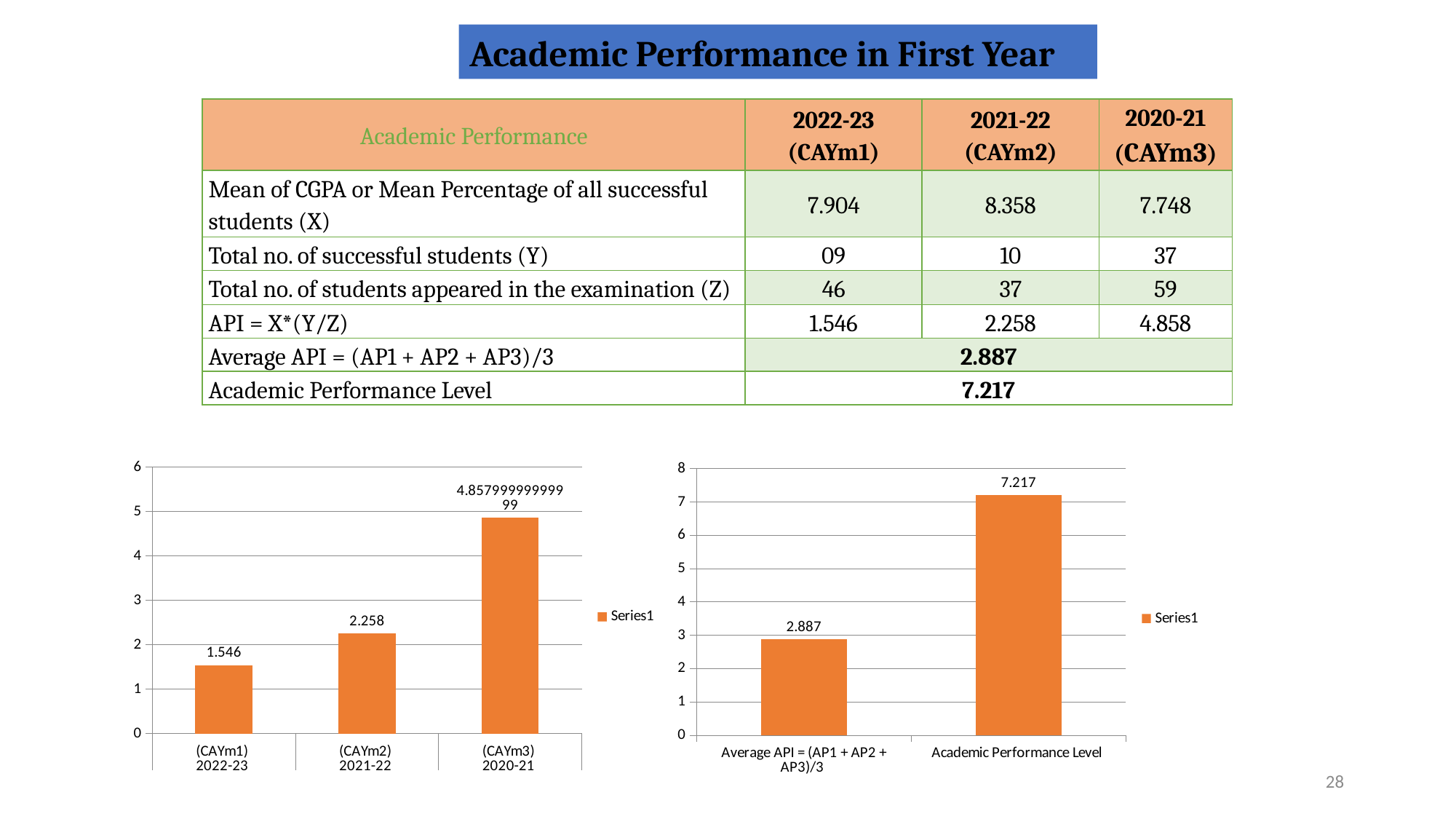
In the right chart, what is the value for Average API = (AP1 + AP2 + AP3)/3? 2.887 In the left chart, what is the value for (CAYm2) 2021-22? 2.258 In the left chart, what is the difference between the values for (CAYm2) 2021-22 and (CAYm1) 2022-23? 0.712 What kind of chart is the right chart? bar chart In the left chart, how many bars are plotted? 3 In the left chart, which category has the highest value? (CAYm3) 2020-21 In the left chart, do the values rise or fall from left to right along the x axis? rise In the left chart, which category has the lowest value? (CAYm1) 2022-23 In the left chart, is the value for (CAYm3) 2020-21 greater or less than 4? greater In the right chart, what is the difference between Academic Performance Level and Average API = (AP1 + AP2 + AP3)/3? 4.33 In the left chart, what is the value for (CAYm1) 2022-23? 1.546 In the right chart, what is the value for Academic Performance Level? 7.217